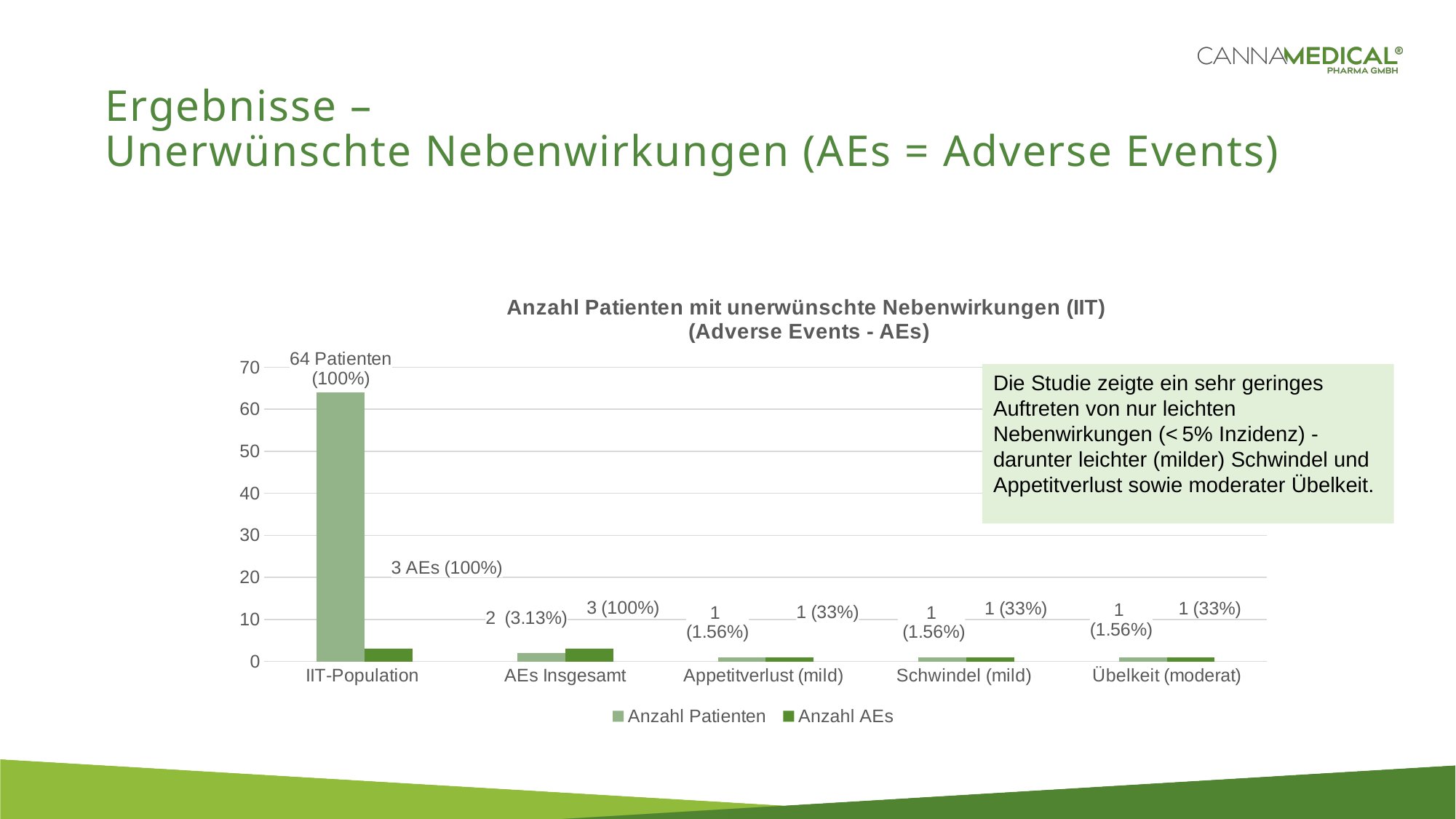
How many categories are shown on the x axis? 5 What is the data label for Anzahl Patienten in the Übelkeit (moderat) category? 1 (1.56%) How many series does the legend list? 2 What is the data label for Anzahl AEs in the IIT-Population category? 3 AEs (100%) What is the data label for Anzahl AEs in the Schwindel (mild) category? 1 (33%) What is the title of the chart? Anzahl Patienten mit unerwünschte Nebenwirkungen (IIT) (Adverse Events - AEs) What kind of chart is shown on the slide? bar chart Is the value for Anzahl Patienten in the IIT-Population category greater or less than 60? greater What is the data label for Anzahl Patienten in the AEs Insgesamt category? 2 (3.13%) What is the data label for Anzahl Patienten in the IIT-Population category? 64 Patienten (100%) Which is larger in the AEs Insgesamt category: Anzahl Patienten or Anzahl AEs? Anzahl AEs Which category has the highest value for Anzahl Patienten? IIT-Population